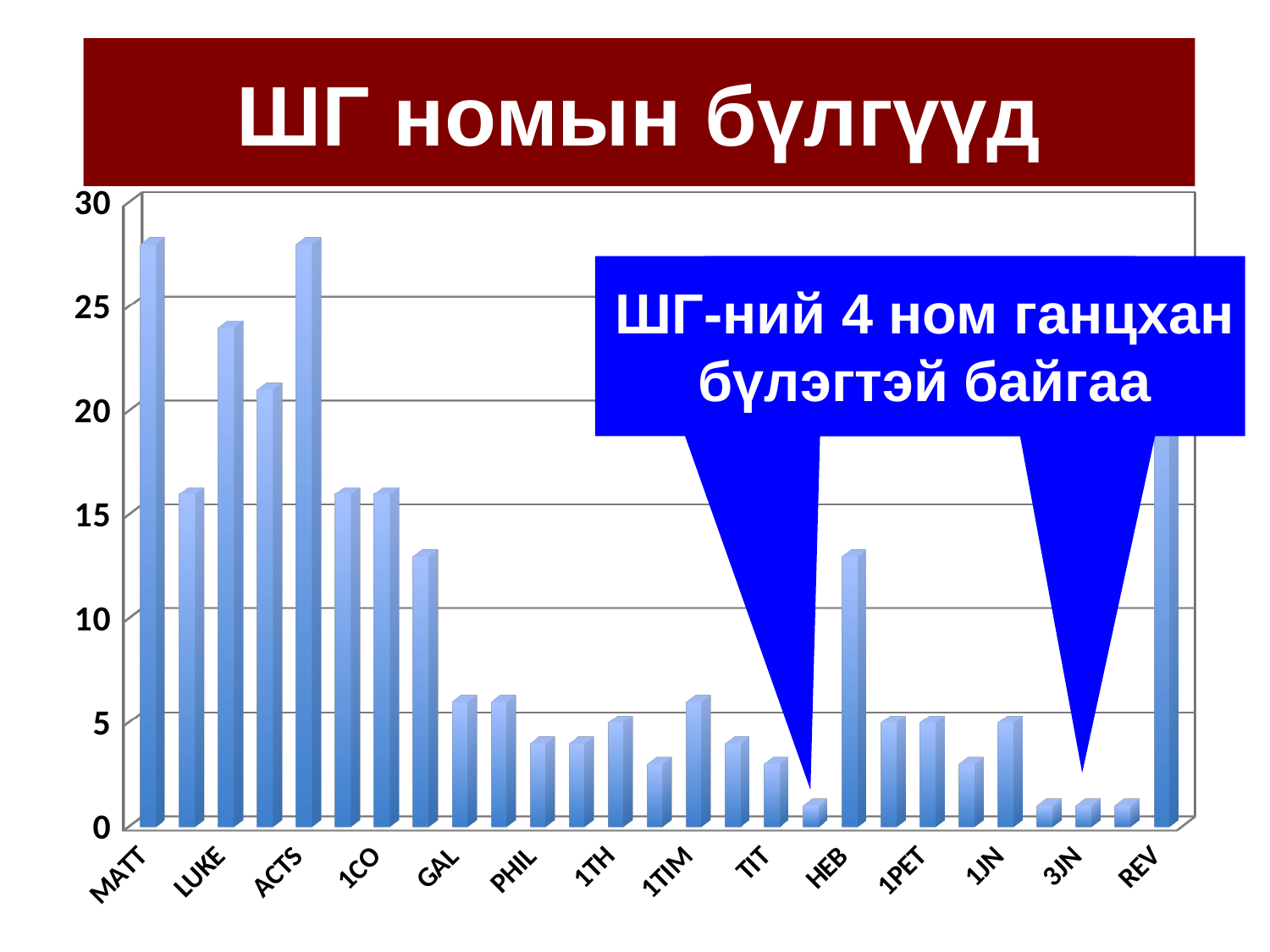
Is the value for TIT greater or less than 5? less What is the title of the chart on the slide? ШГ номын бүлгүүд Is the value for REV greater or less than 15? greater Is the value for LUKE greater or less than 20? greater Which is larger, the value for HEB or the value for GAL? HEB How many category labels are shown along the x axis? 14 What kind of chart is shown on the slide? bar chart Which is larger, the value for MATT or the value for LUKE? MATT Which is larger, the value for ACTS or the value for 1CO? ACTS